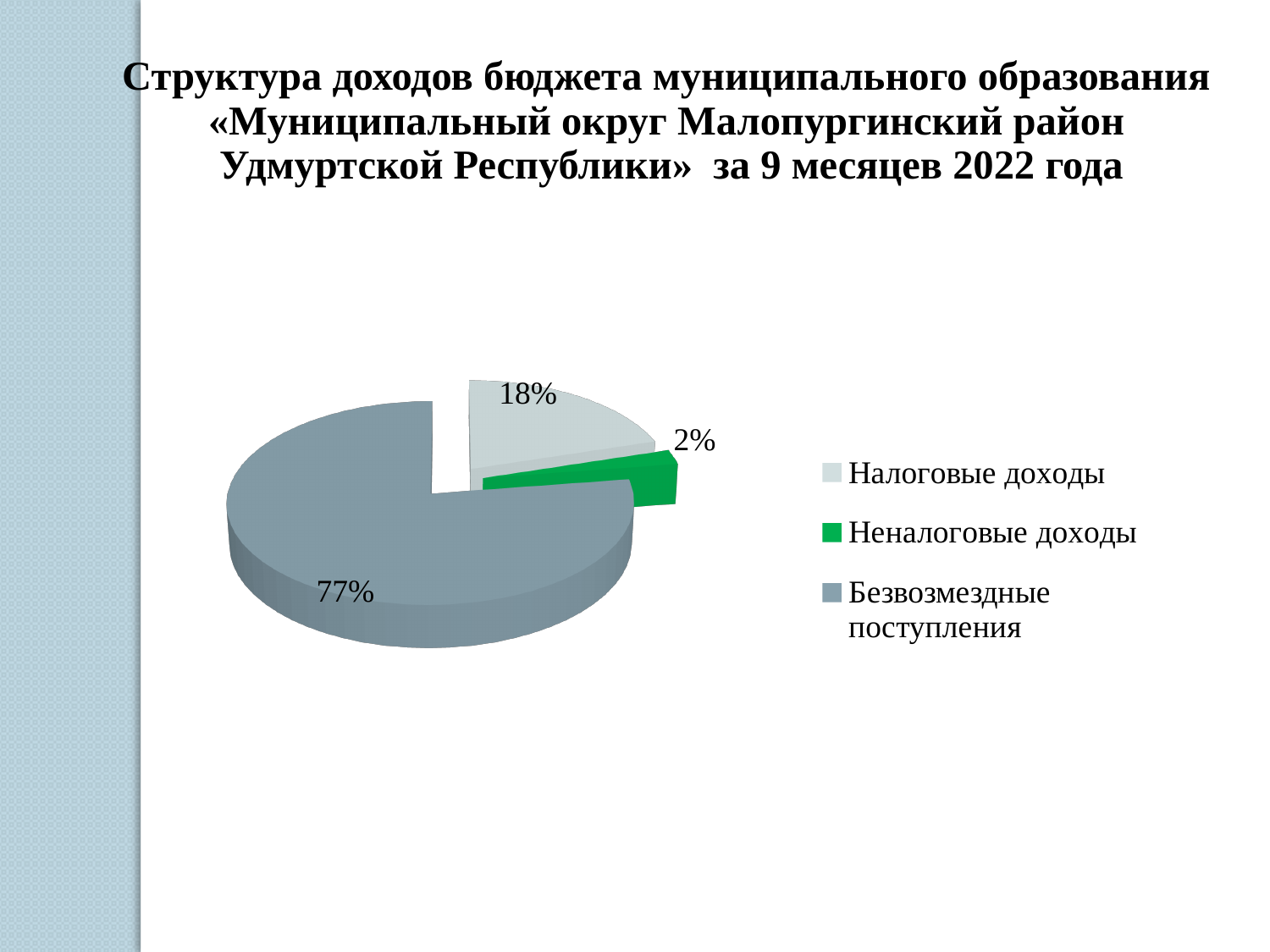
Which category is shown in green in the pie chart? Неналоговые доходы What is the difference in percentage points between Безвозмездные поступления and Налоговые доходы? 59 Which category has the largest share of the pie? Безвозмездные поступления What kind of chart is shown on the slide? Pie chart Which is larger, Налоговые доходы or Неналоговые доходы? Налоговые доходы What share of the pie is Налоговые доходы? 18% Which period does the chart title say the data covers? 9 месяцев 2022 года Which category has the smallest share of the pie? Неналоговые доходы What share of the pie is Безвозмездные поступления? 77% What is the difference in percentage points between Налоговые доходы and Неналоговые доходы? 16 What share of the pie is Неналоговые доходы? 2% How many categories does the pie chart show? 3